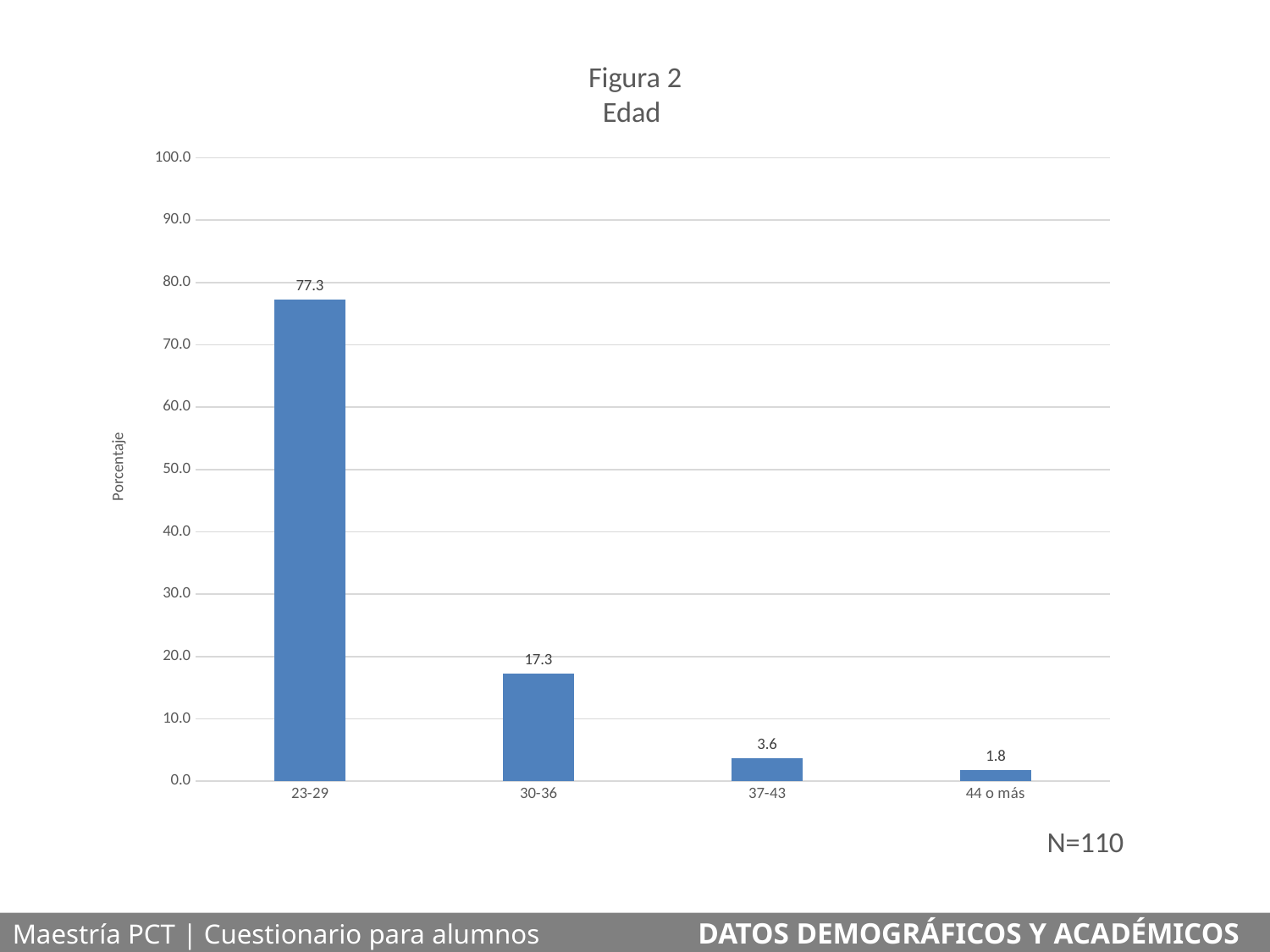
Which age group has the highest value? 23-29 How many age groups are shown on the x axis? 4 What is the difference between the values for 23-29 and 30-36? 60.0 What kind of chart is shown? bar chart Which is larger, the value for 37-43 or the value for 44 o más? 37-43 What is the value for the 44 o más age group? 1.8 Do the values rise or fall from left to right along the x axis? fall Is the value for 30-36 greater or less than 20.0? less What is the value for the 37-43 age group? 3.6 Which age group has the lowest value? 44 o más What is the value for the 30-36 age group? 17.3 What is the value for the 23-29 age group? 77.3